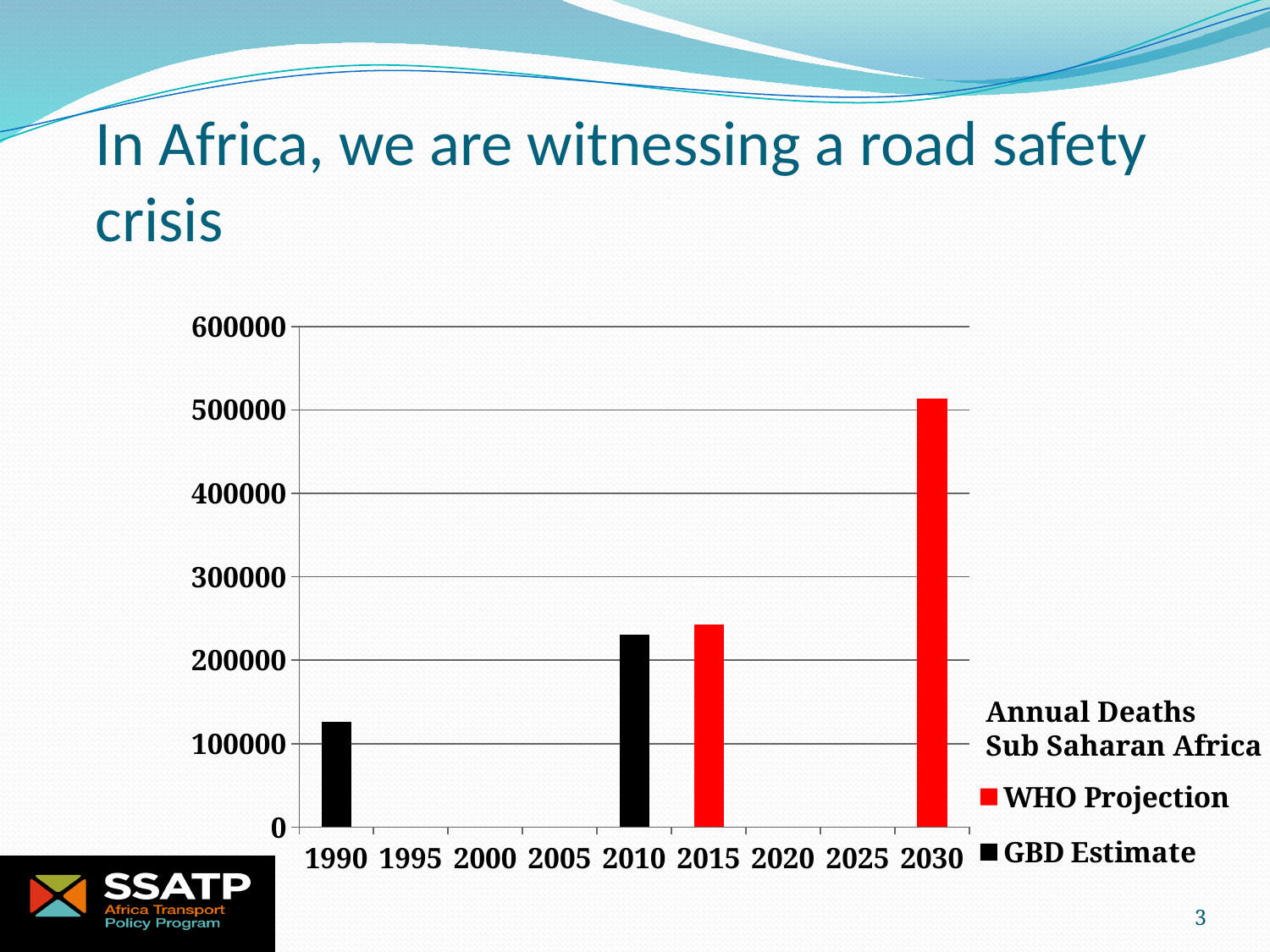
How many series does the chart legend list? 2 Is the WHO Projection value for 2030 greater or less than 500000? greater Which year has the lowest bar in the chart? 1990 What kind of chart is shown on the slide? bar chart How many year labels are shown along the x axis of the chart? 9 Is the GBD Estimate value for 2010 greater or less than 200000? greater Which year has the highest bar in the chart? 2030 Is the WHO Projection value for 2015 greater or less than 300000? less Which series is shown in red in the chart? WHO Projection Which is larger, the bar for 2030 or the bar for 2015? 2030 Which series is shown in black in the chart? GBD Estimate